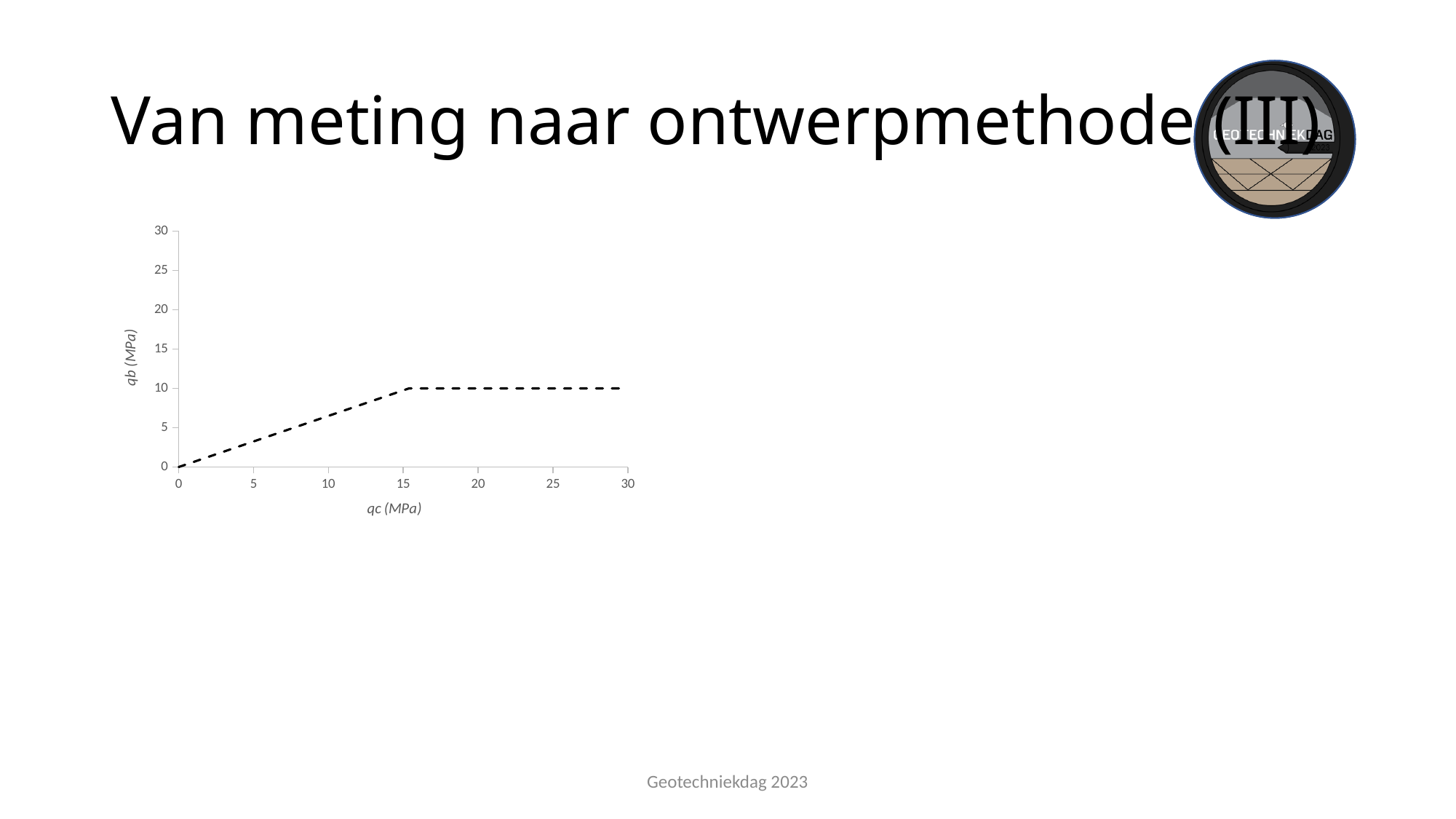
Is the value of qb at qc = 5 MPa greater or less than 5? less What is the label of the x axis of the chart? qc (MPa) What kind of chart is shown on the slide? line chart Does qb rise, fall or stay flat as qc increases from 15 to 30 MPa? stay flat What is the value of qb at qc = 30 MPa? 10 Is the value of qb at qc = 10 MPa greater or less than 5? greater Does qb rise or fall as qc increases from 0 to 15 MPa? rise Which is larger, qb at qc = 5 MPa or qb at qc = 20 MPa? qb at qc = 20 MPa What is the value of qb at qc = 15 MPa? 10 What is the label of the y axis of the chart? qb (MPa) What is the value of qb at qc = 0 MPa? 0 Is the value of qb at qc = 10 MPa greater or less than 10? less